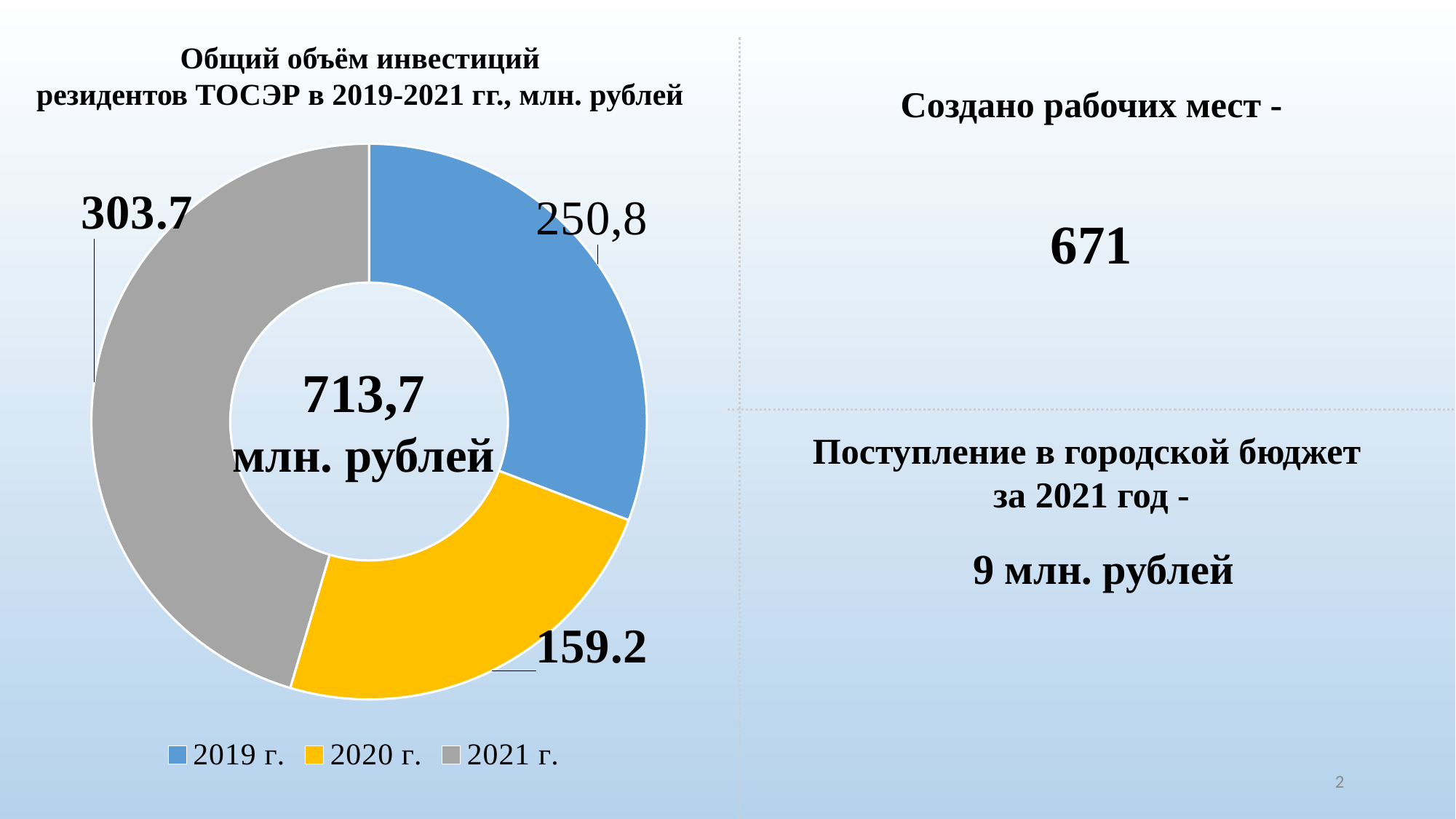
How many slices does the doughnut chart have? 3 How many entries does the legend of the doughnut chart list? 3 What is the difference between the values for 2021 г. and 2019 г. in the doughnut chart? 52.9 What is the value for 2019 г. in the doughnut chart? 250,8 What is the difference between the values for 2019 г. and 2020 г. in the doughnut chart? 91.6 Which is larger in the doughnut chart, the value for 2019 г. or the value for 2020 г.? 2019 г. Which year has the smallest slice in the doughnut chart? 2020 г. What total value is printed in the centre of the doughnut chart? 713,7 млн. рублей What type of chart is shown on the slide? doughnut chart What is the value for 2020 г. in the doughnut chart? 159.2 What is the value for 2021 г. in the doughnut chart? 303.7 Which year has the largest slice in the doughnut chart? 2021 г.